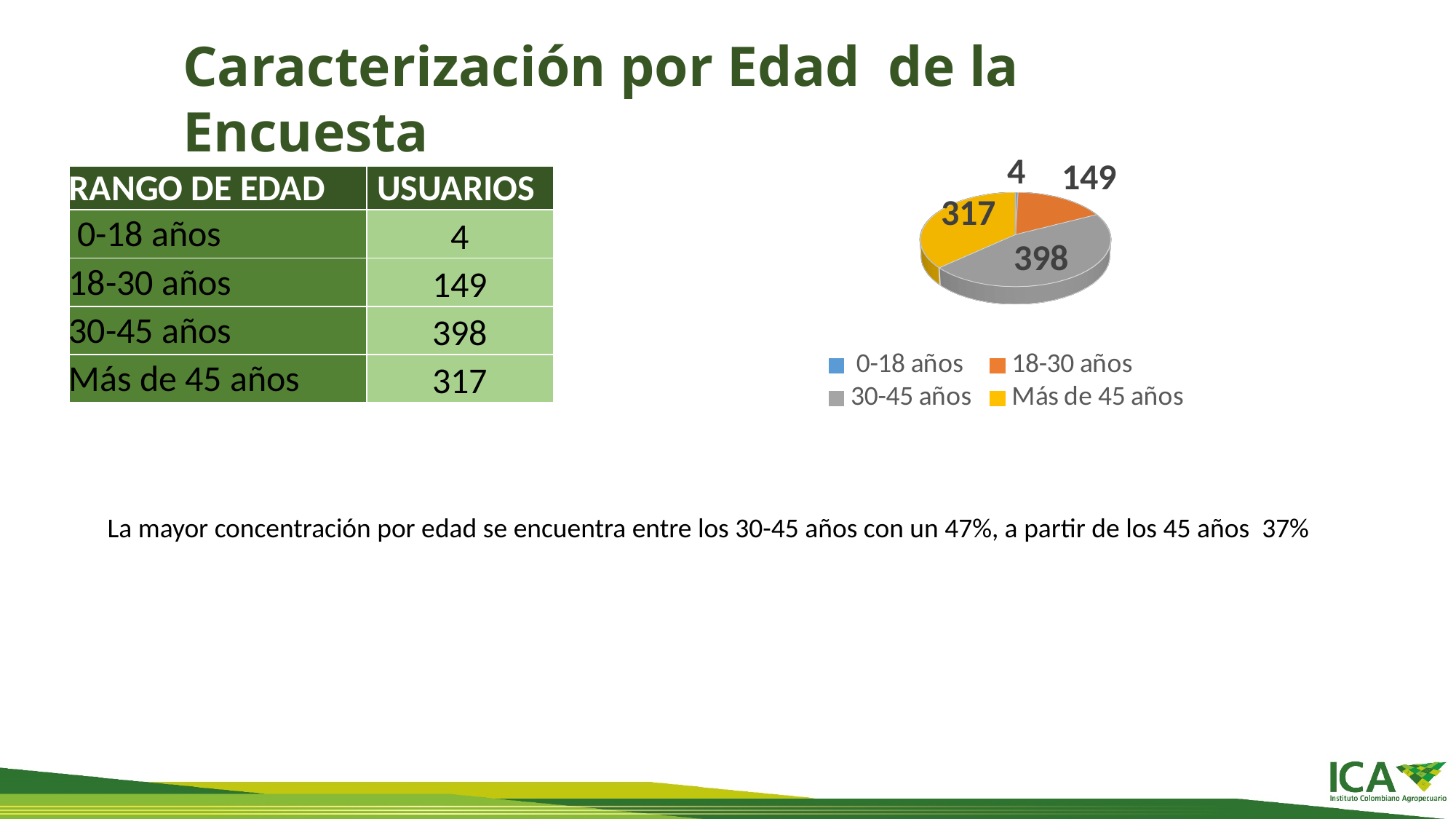
What is the value for the 0-18 años slice in the pie chart? 4 What is the value for the 18-30 años slice in the pie chart? 149 What is the total of all the values shown in the pie chart? 868 What is the difference between the 30-45 años and Más de 45 años values in the pie chart? 81 What is the value for the Más de 45 años slice in the pie chart? 317 What is the value for the 30-45 años slice in the pie chart? 398 Which age range has the largest slice in the pie chart? 30-45 años What kind of chart is shown on the slide? pie chart How many slices does the pie chart have? 4 What colour is the 30-45 años slice in the pie chart? grey Which is larger in the pie chart, 18-30 años or Más de 45 años? Más de 45 años Which age range has the smallest slice in the pie chart? 0-18 años